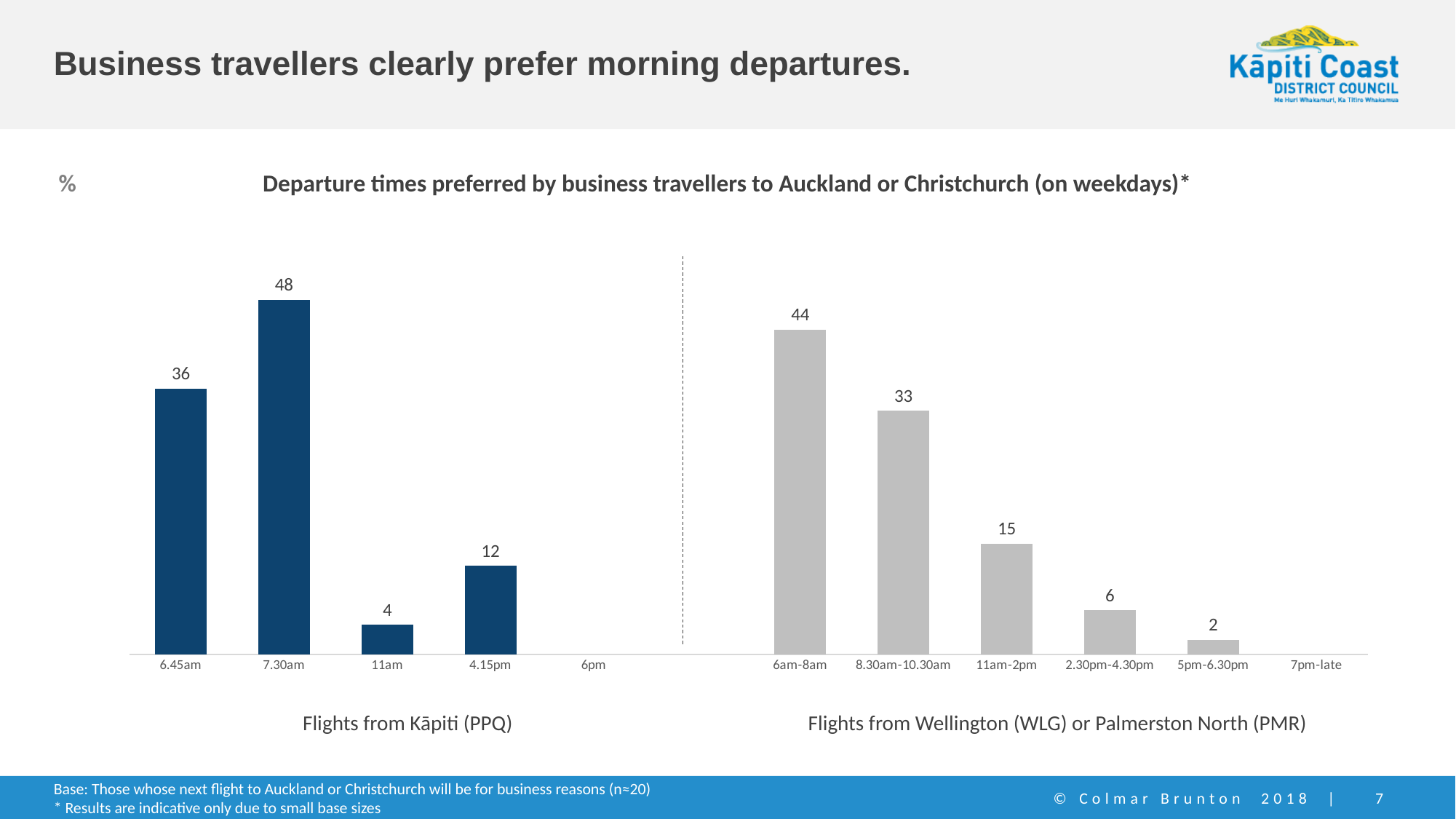
How many departure time categories are shown on the x axis for the Flights from Wellington (WLG) or Palmerston North (PMR) section? 6 What is the title of the chart? Departure times preferred by business travellers to Auckland or Christchurch (on weekdays)* In the Flights from Kāpiti (PPQ) section, what is the value for 7.30am? 48 In the Flights from Wellington (WLG) or Palmerston North (PMR) section, do the values rise or fall from 6am-8am to 5pm-6.30pm? Fall In the Flights from Kāpiti (PPQ) section, what is the value for 4.15pm? 12 In the Flights from Wellington (WLG) or Palmerston North (PMR) section, which departure time has the highest value? 6am-8am What is the difference between the 7.30am and 6.45am values in the Flights from Kāpiti (PPQ) section? 12 What is the difference between the 6am-8am and 11am-2pm values in the Flights from Wellington (WLG) or Palmerston North (PMR) section? 29 In the Flights from Kāpiti (PPQ) section, which departure time with a bar has the lowest value? 11am Which is larger: the 6.45am value for Flights from Kāpiti (PPQ) or the 6am-8am value for Flights from Wellington (WLG) or Palmerston North (PMR)? 6am-8am for Flights from Wellington (WLG) or Palmerston North (PMR) What kind of chart is shown on the slide? Bar chart In the Flights from Wellington (WLG) or Palmerston North (PMR) section, what is the value for 8.30am-10.30am? 33